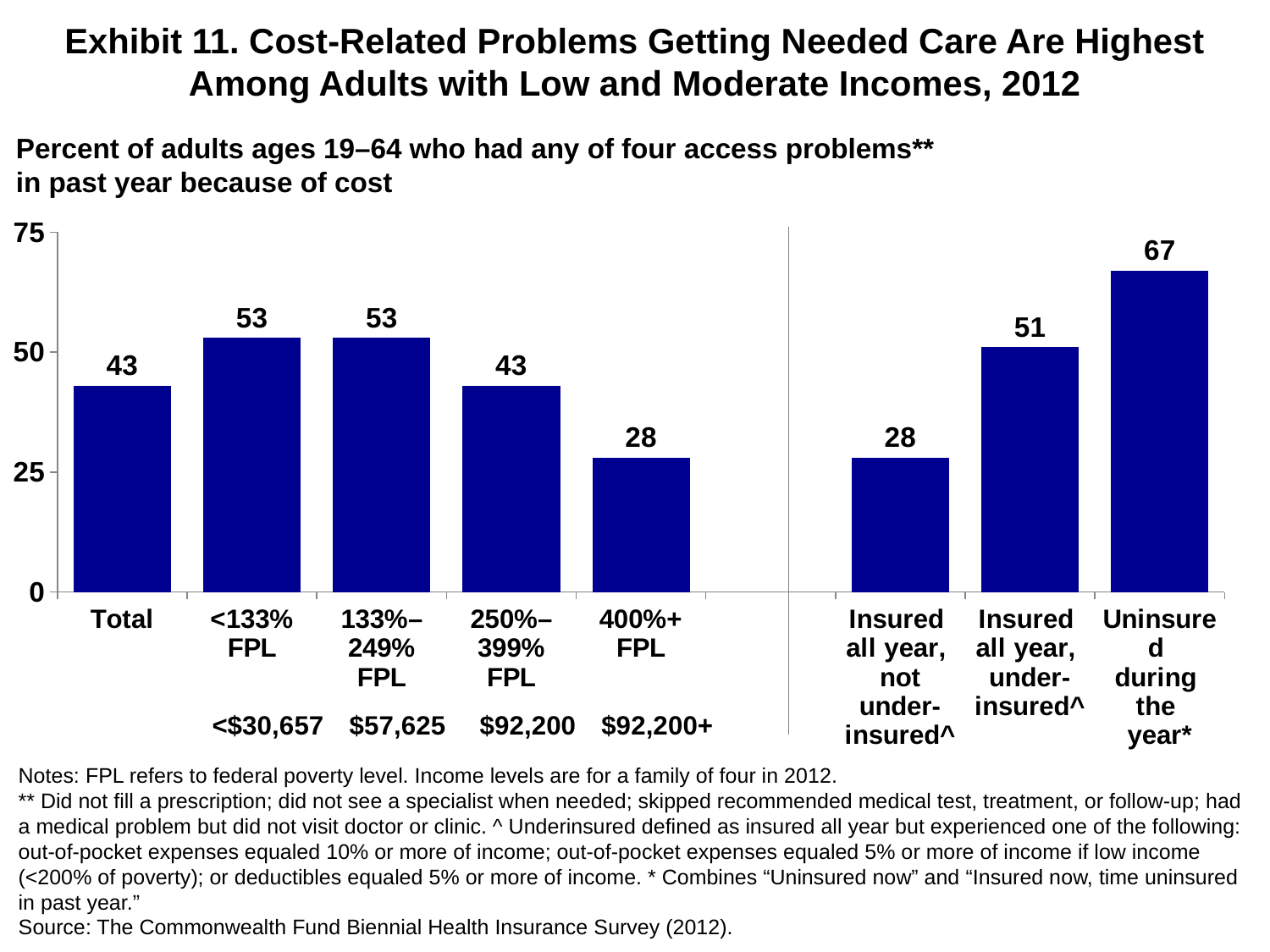
What is the value for Total? 43 What is the highest value shown on the vertical axis? 75 Is the value for Insured all year, underinsured greater or less than 50? greater How many bars are shown on the chart? 8 What income level in dollars is shown under the 250%–399% FPL category? $92,200 What is the value for adults insured all year, underinsured? 51 Which is larger, the value for 133%–249% FPL or the value for 250%–399% FPL? 133%–249% FPL Which category has the highest value? Uninsured during the year What kind of chart is shown on the slide? Bar chart What is the difference between the values for Uninsured during the year and Insured all year, not underinsured? 39 What is the value for adults with incomes of 400%+ FPL? 28 What is the difference between the values for <133% FPL and 400%+ FPL? 25